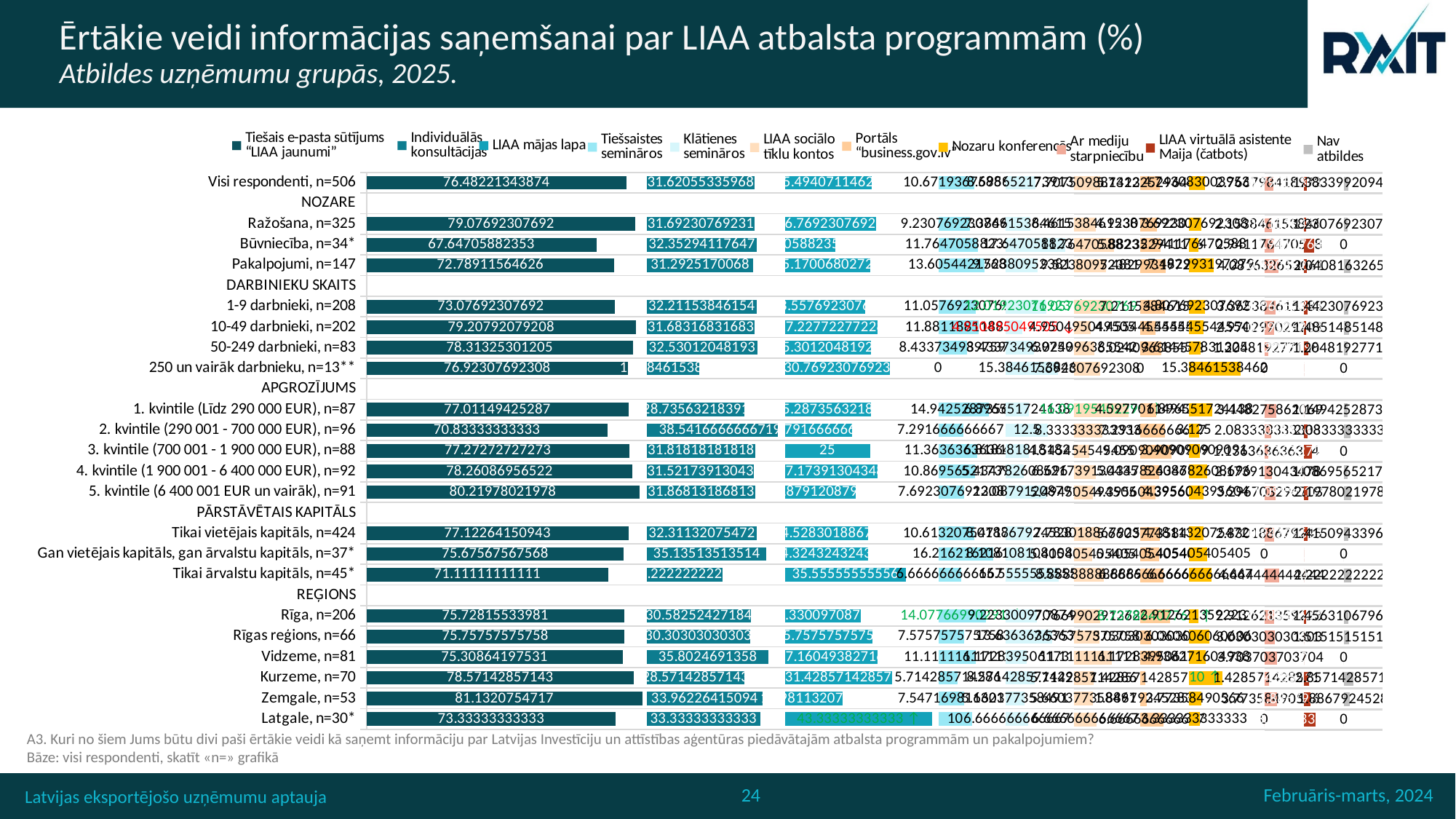
What is the value for Individuālās konsultācijas for Ražošana, n=325? 31.69230769231 Which is larger for Tiešais e-pasta sūtījums "LIAA jaunumi": Ražošana, n=325 or Pakalpojumi, n=147? Ražošana, n=325 What is the value for Individuālās konsultācijas for Vidzeme, n=81? 35.8024691358 What kind of chart is shown on the slide? Bar chart Which group has the lowest value for Tiešais e-pasta sūtījums "LIAA jaunumi"? Būvniecība, n=34* How many series does the legend list? 11 Which group has the highest value for Tiešais e-pasta sūtījums "LIAA jaunumi"? Zemgale, n=53 What is the value for Tiešais e-pasta sūtījums "LIAA jaunumi" for Būvniecība, n=34*? 67.64705882353 What is the value for Tiešais e-pasta sūtījums "LIAA jaunumi" for Zemgale, n=53? 81.1320754717 What is the difference between the Tiešais e-pasta sūtījums "LIAA jaunumi" values for 10-49 darbnieki, n=202 and 1-9 darbnieki, n=208? 6.13099771516 What is the value for Tiešais e-pasta sūtījums "LIAA jaunumi" for Visi respondenti, n=506? 76.48221343874 What is the value for LIAA mājas lapa for 3. kvintile (700 001 - 1 900 000 EUR), n=88? 25